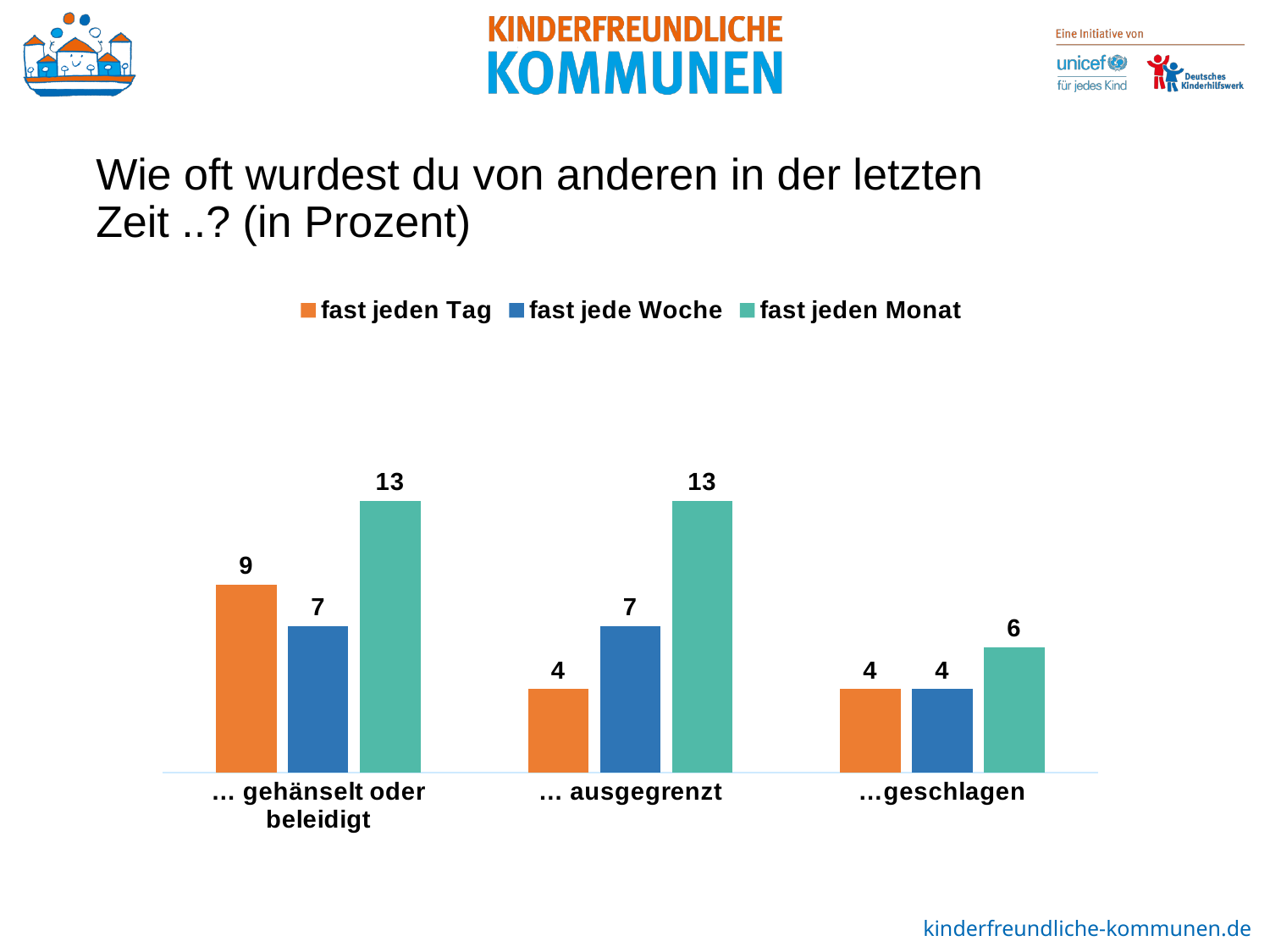
Which colour represents the 'fast jede Woche' series? blue Which is larger in the '… gehänselt oder beleidigt' category: 'fast jeden Tag' or 'fast jede Woche'? fast jeden Tag Which category has the highest value for 'fast jeden Tag'? … gehänselt oder beleidigt What is the value for 'fast jede Woche' in the '…geschlagen' category? 4 What is the difference between 'fast jeden Monat' and 'fast jeden Tag' in the '… ausgegrenzt' category? 9 What is the value for 'fast jeden Tag' in the '… gehänselt oder beleidigt' category? 9 What kind of chart is shown on the slide? bar chart Which category has the lowest value for 'fast jeden Monat'? …geschlagen What is the value for 'fast jeden Monat' in the '… ausgegrenzt' category? 13 Does the value for 'fast jeden Monat' rise or fall from '… ausgegrenzt' to '…geschlagen'? fall How many series does the legend list? 3 How many categories are shown on the x axis? 3